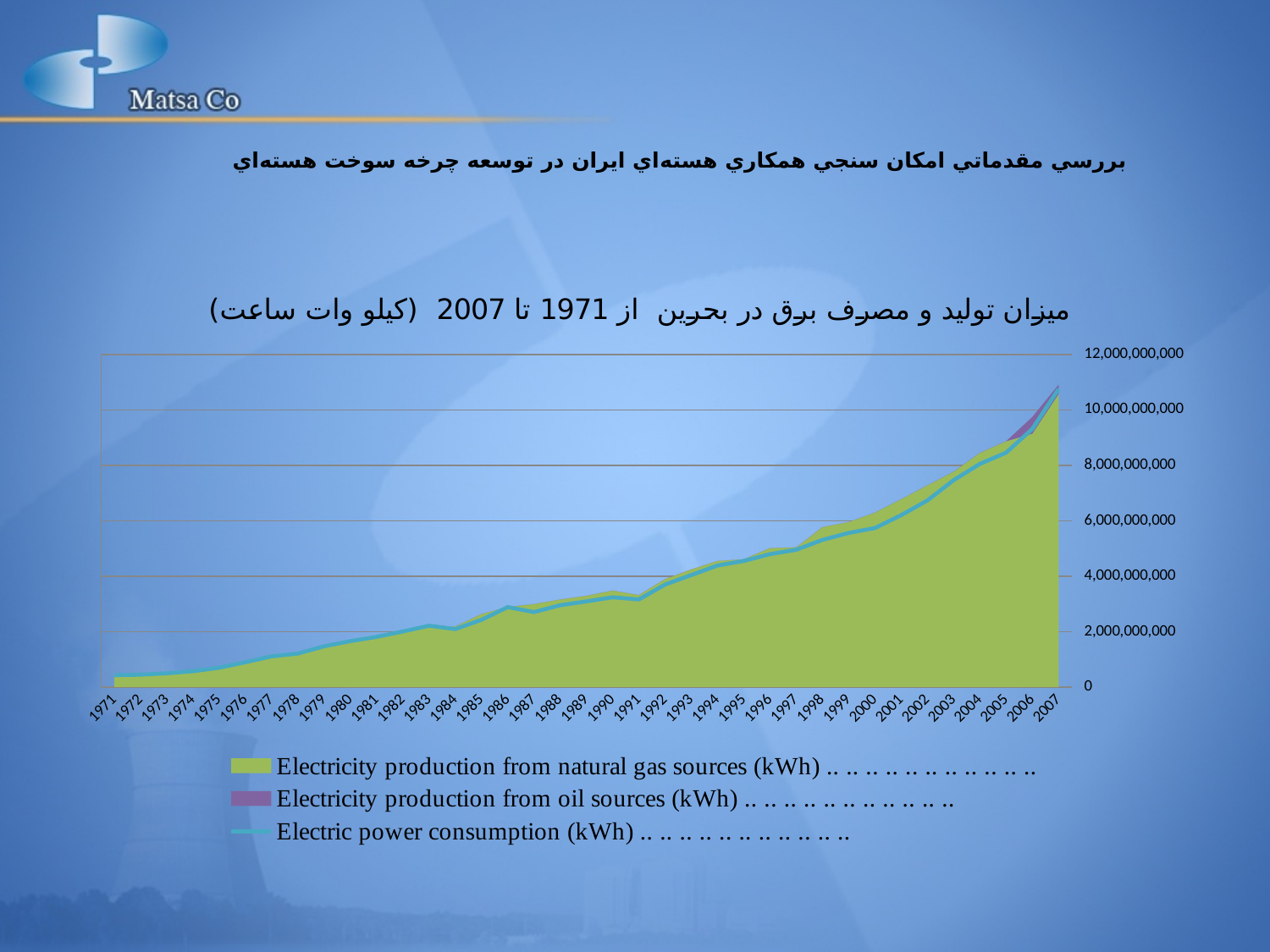
How many series does the chart legend list? 3 In which year is electric power consumption lowest? 1971 In which year is electric power consumption highest? 2007 Which series is shown in green in the chart legend? Electricity production from natural gas sources (kWh) Is the value for electric power consumption in 2007 greater or less than 10,000,000,000? greater What is the highest value shown on the chart's y axis? 12,000,000,000 Which year has the larger electric power consumption, 1980 or 2005? 2005 Is the value for electric power consumption in 2000 greater or less than 4,000,000,000? greater How many years are plotted along the x axis of the chart? 37 What kind of chart is shown on the slide? area chart Do the values for electric power consumption generally rise or fall from 1971 to 2007? rise Is the value for electric power consumption in 1971 greater or less than 2,000,000,000? less